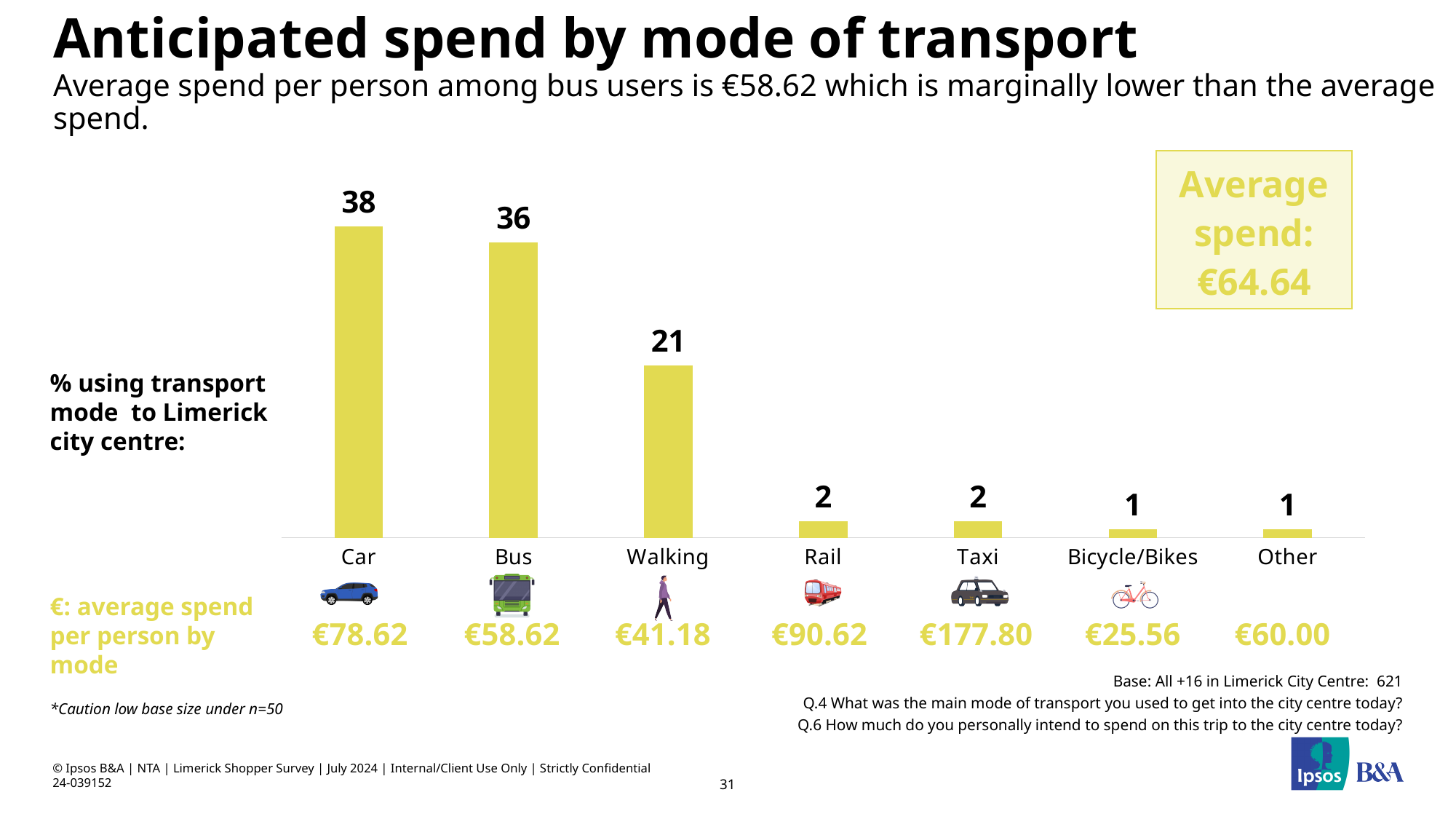
What is the overall average spend shown in the box on the slide? €64.64 What is the average spend per person among taxi users? €177.80 Which has a higher percentage of users, Bus or Walking? Bus Which mode of transport has the lowest average spend per person? Bicycle/Bikes What is the average spend per person among bicycle/bike users? €25.56 What percentage of people use the car as their mode of transport to Limerick city centre? 38 Which mode of transport has the highest percentage of users? Car How many modes of transport are shown in the chart? 7 What is the difference between the average spend per person for rail users and car users? €12.00 What is the difference in percentage points between car users and bus users? 2 What kind of chart is used to show the percentage using each transport mode? Bar chart What percentage of people use walking as their mode of transport to Limerick city centre? 21